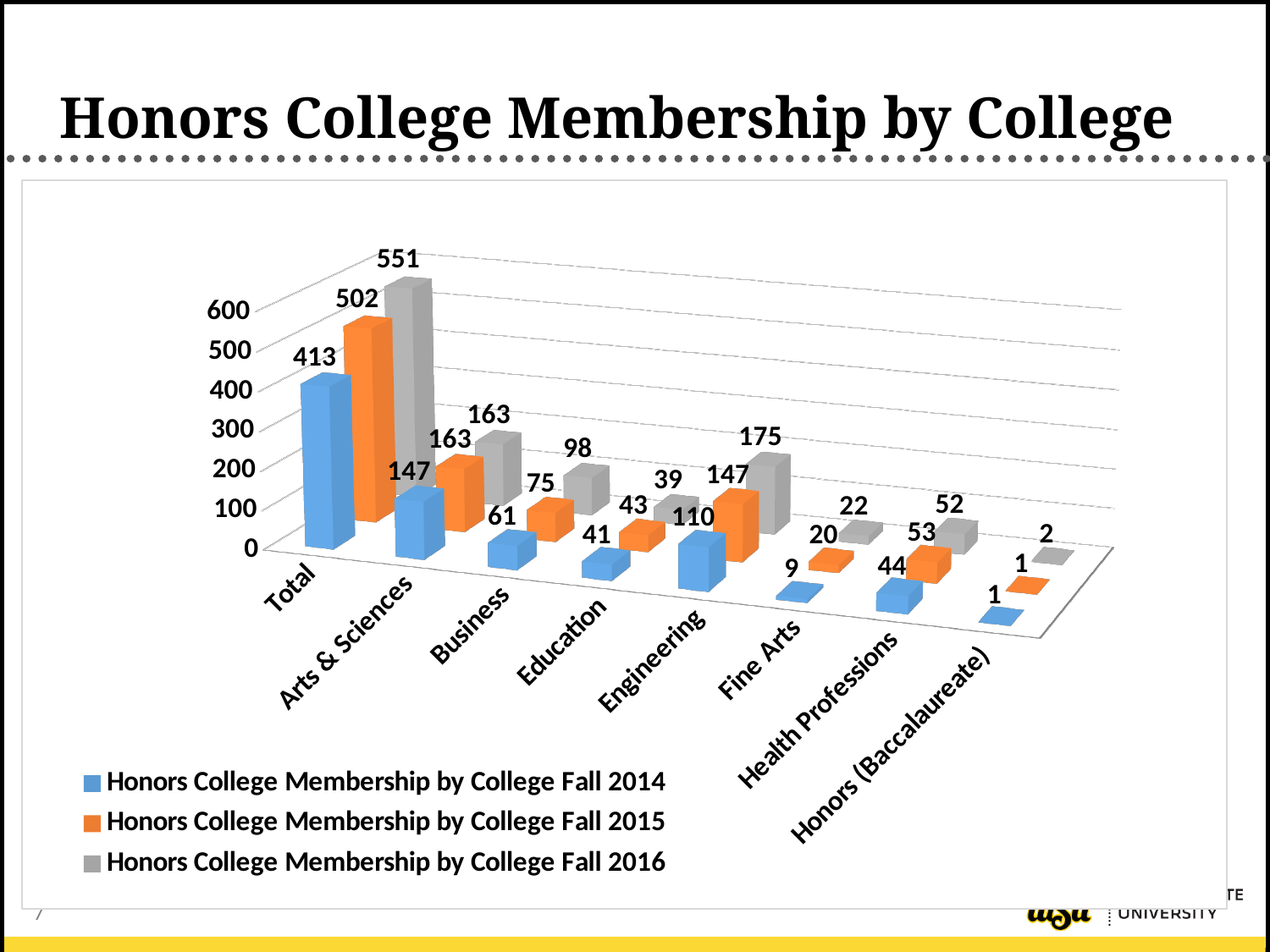
Excluding Total, which college has the highest Fall 2016 membership? Engineering What is the Fall 2014 Honors College membership for Business? 61 What is the Fall 2015 Honors College membership for Fine Arts? 20 Which is larger: the Fall 2015 membership for Business or the Fall 2015 membership for Education? Business What is the difference between the Total membership in Fall 2016 and Fall 2014? 138 Which college has the lowest Fall 2014 membership? Honors (Baccalaureate) What is the Total Honors College membership for Fall 2016? 551 How many college categories are shown on the x axis? 8 How many series does the legend list? 3 What is the Fall 2016 Honors College membership for Engineering? 175 Which colour represents the Fall 2015 series? Orange What kind of chart is shown on the slide? Bar chart